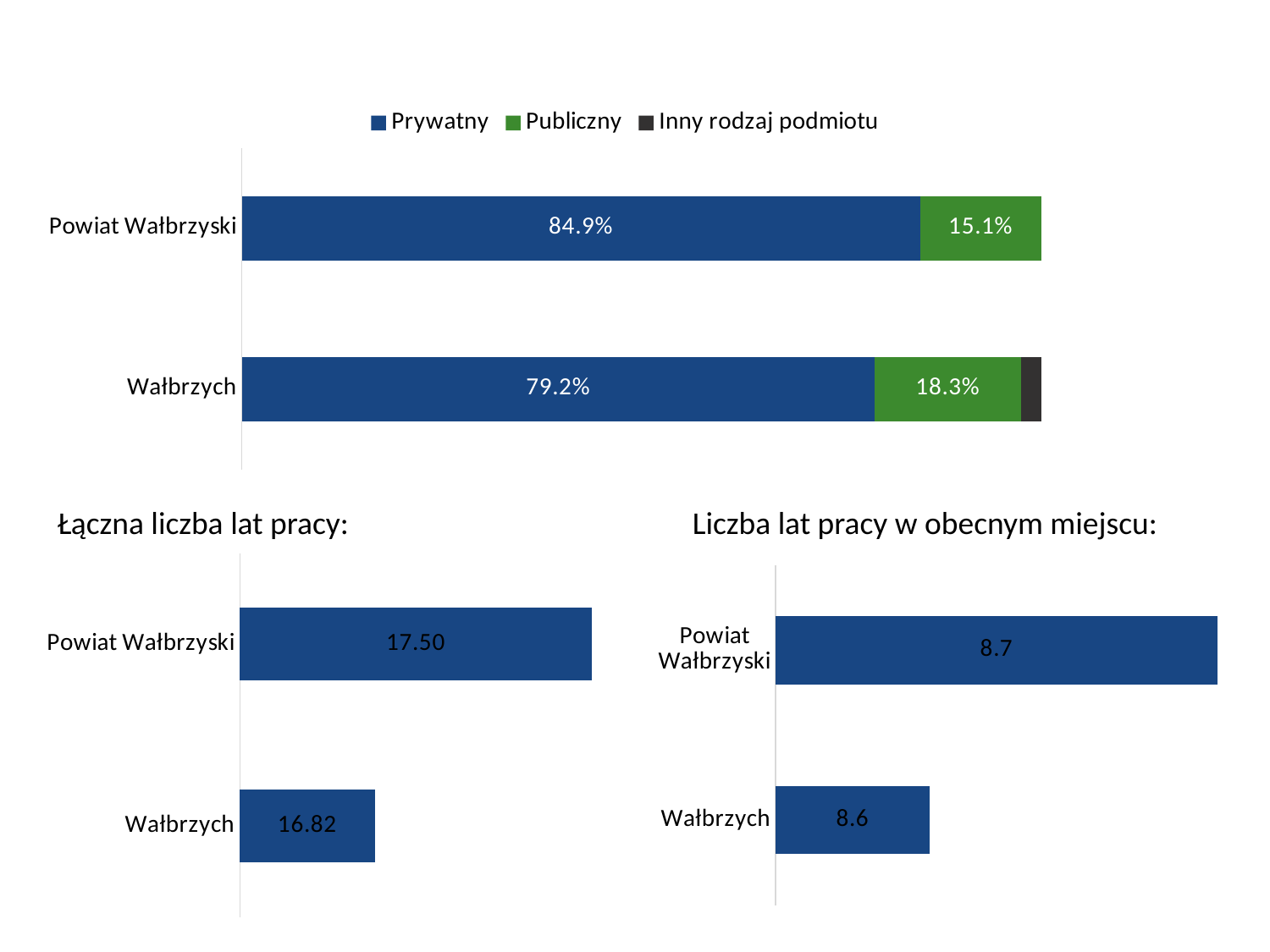
In the top stacked bar chart, what is the difference between the Prywatny values for Powiat Wałbrzyski and Wałbrzych? 5.7% What kind of chart is the chart titled 'Liczba lat pracy w obecnym miejscu:'? bar chart In the chart titled 'Łączna liczba lat pracy:', which category has the highest value? Powiat Wałbrzyski In the top stacked bar chart, what is the Prywatny value for Powiat Wałbrzyski? 84.9% In the top stacked bar chart, which series is shown in green? Publiczny In the top stacked bar chart, how many series does the legend list? 3 In the top stacked bar chart, what is the Prywatny value for Wałbrzych? 79.2% In the top stacked bar chart, what is the Publiczny value for Wałbrzych? 18.3% In the chart titled 'Łączna liczba lat pracy:', what is the difference between Powiat Wałbrzyski and Wałbrzych? 0.68 In the chart titled 'Liczba lat pracy w obecnym miejscu:', what is the value for Powiat Wałbrzyski? 8.7 In the chart titled 'Łączna liczba lat pracy:', what is the value for Wałbrzych? 16.82 In the top stacked bar chart, which category has the larger Publiczny share, Powiat Wałbrzyski or Wałbrzych? Wałbrzych